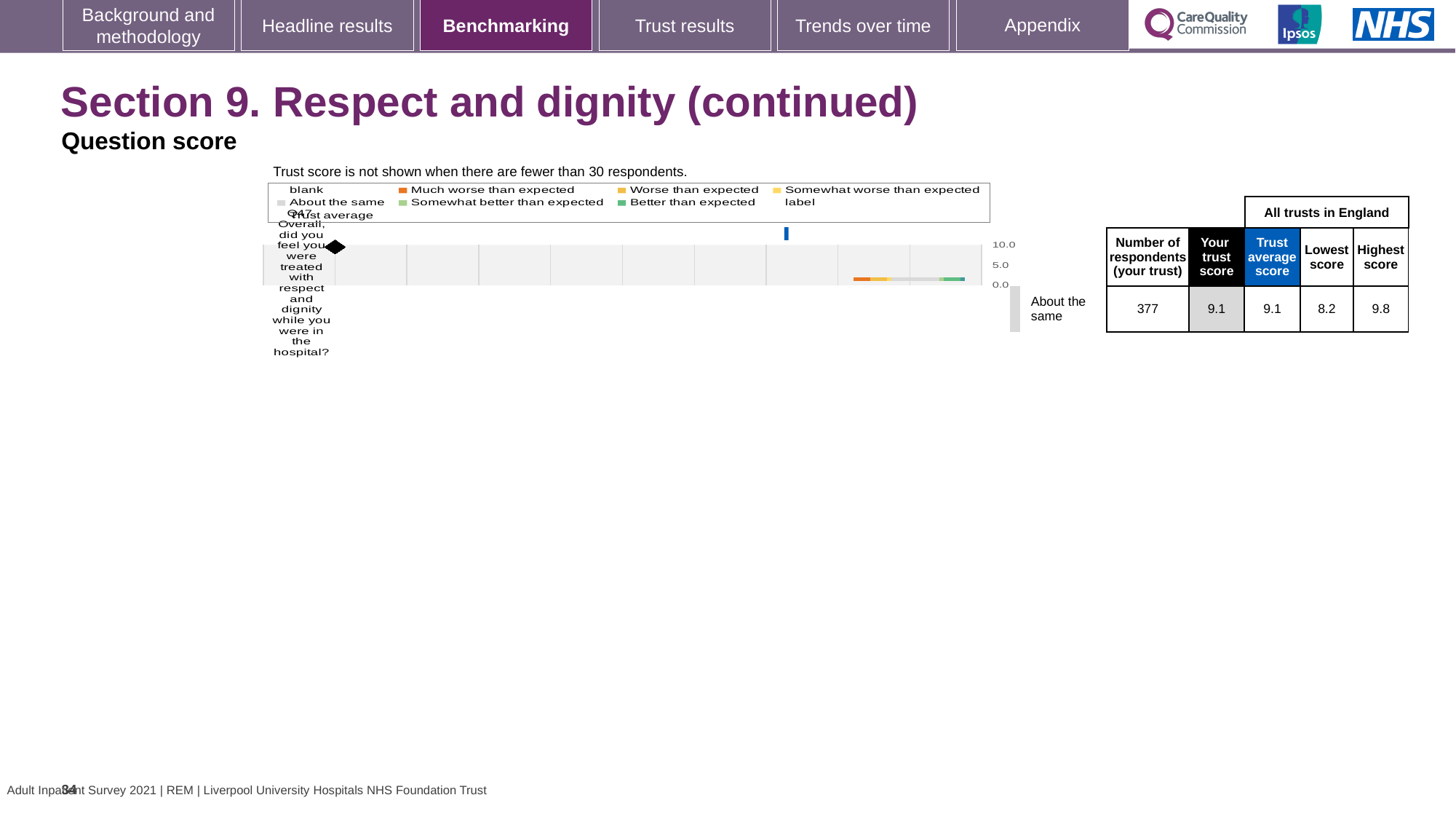
What benchmark category is the trust's Q47 score placed in? About the same What is the highest score across all trusts in England for Q47? 9.8 What is the trust score for Q47 shown in the table beside the chart? 9.1 What is the trust average score for Q47? 9.1 Is the trust score for Q47 greater or less than 5.0 on the chart's axis? greater What is the highest value shown on the chart's axis? 10.0 Which is larger for Q47: the highest score across all trusts or your trust score? the highest score What type of chart is shown on the slide? bar chart What is the lowest score across all trusts in England for Q47? 8.2 How many respondents from the trust answered Q47? 377 Which question number is plotted on the chart? Q47 What is the difference between the highest score and the lowest score for Q47? 1.6